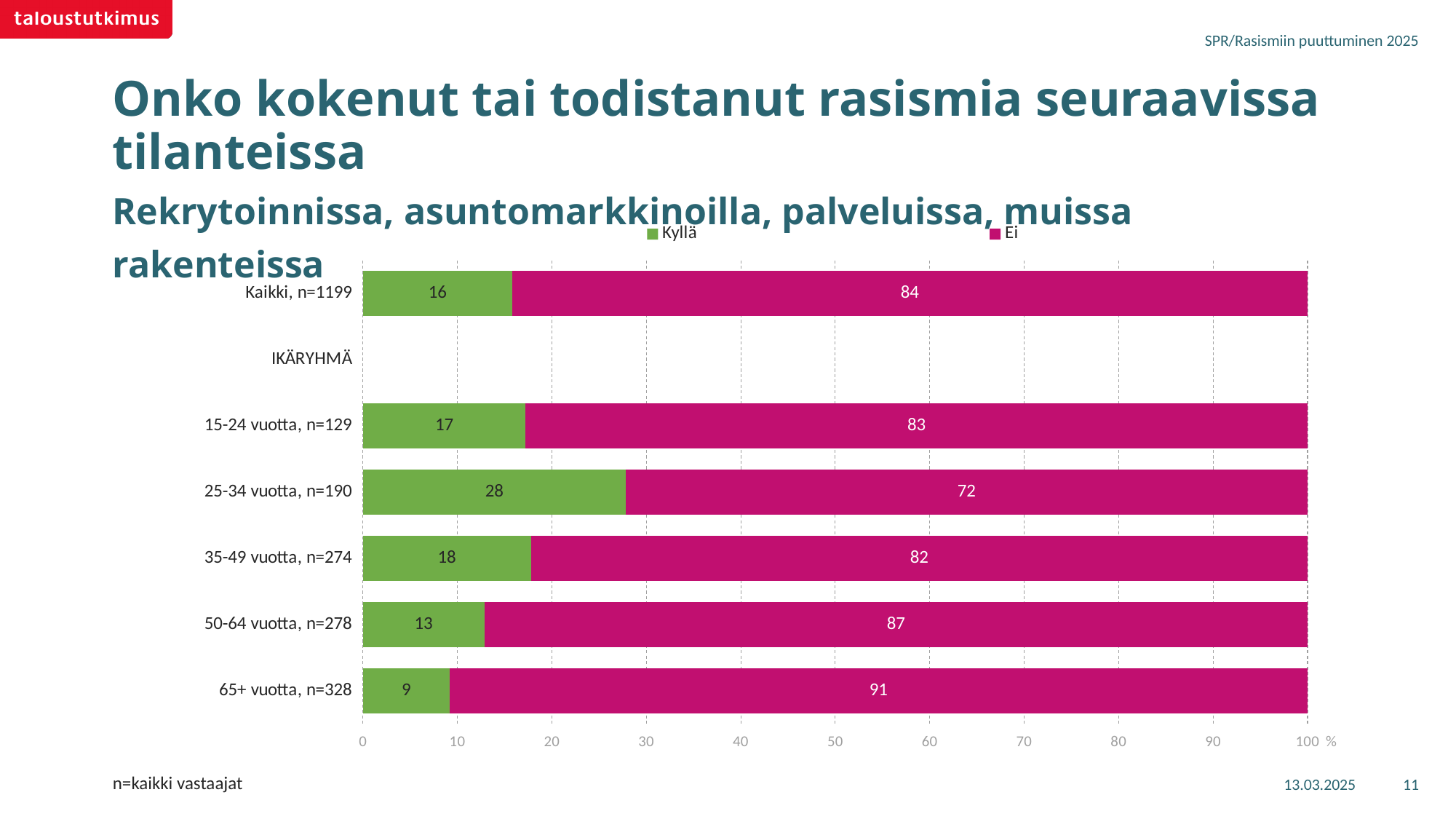
Which age group has the lowest Kyllä value? 65+ vuotta, n=328 Which has a larger Kyllä value, 35-49 vuotta, n=274 or 50-64 vuotta, n=278? 35-49 vuotta, n=274 Which age group has the highest Kyllä value? 25-34 vuotta, n=190 How many series does the legend list? 2 What is the difference between the Ei values for 65+ vuotta, n=328 and 15-24 vuotta, n=129? 8 What is the Kyllä value for Kaikki, n=1199? 16 What is the Ei value for 25-34 vuotta, n=190? 72 What is the Kyllä value for 65+ vuotta, n=328? 9 What is the total of the stacked bar for 50-64 vuotta, n=278? 100 What kind of chart is shown on the slide? Stacked bar chart How many age groups are plotted under IKÄRYHMÄ? 5 What colour represents the Ei series? Magenta/pink